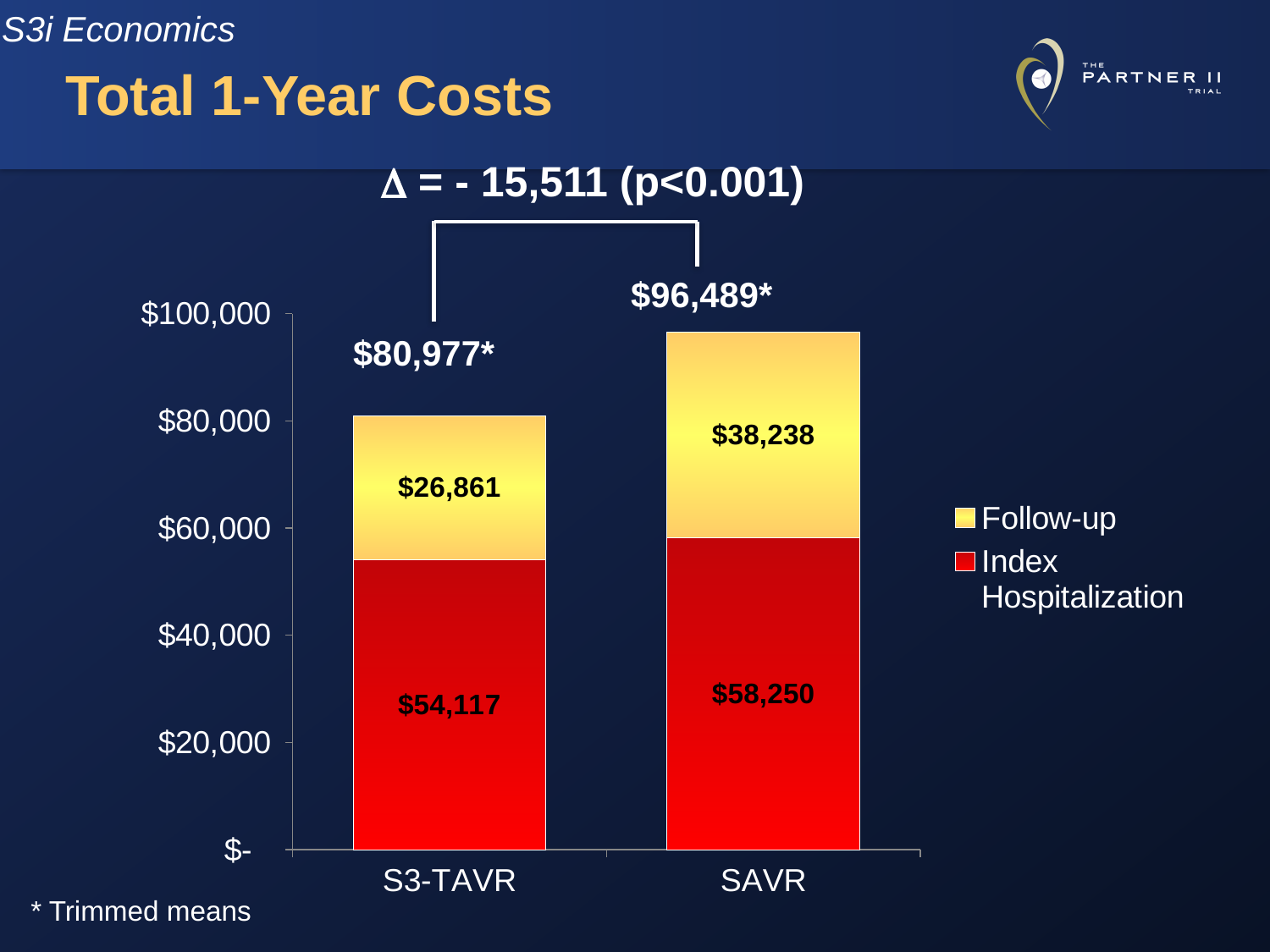
What is the difference in Follow-up cost between SAVR and S3-TAVR? $11,377 What is the total 1-year cost shown above the SAVR bar? $96,489 What is the Follow-up cost for SAVR? $38,238 What difference (Δ) between the two groups is annotated at the top of the chart? - 15,511 (p<0.001) What is the total 1-year cost shown above the S3-TAVR bar? $80,977 How many categories are shown on the x axis? 2 Which category has the higher total 1-year cost? SAVR Which is larger, the Index Hospitalization cost for SAVR or for S3-TAVR? SAVR What is the Index Hospitalization cost for S3-TAVR? $54,117 How many series does the legend list? 2 What is the Follow-up cost for S3-TAVR? $26,861 What type of chart is shown on the slide? stacked bar chart